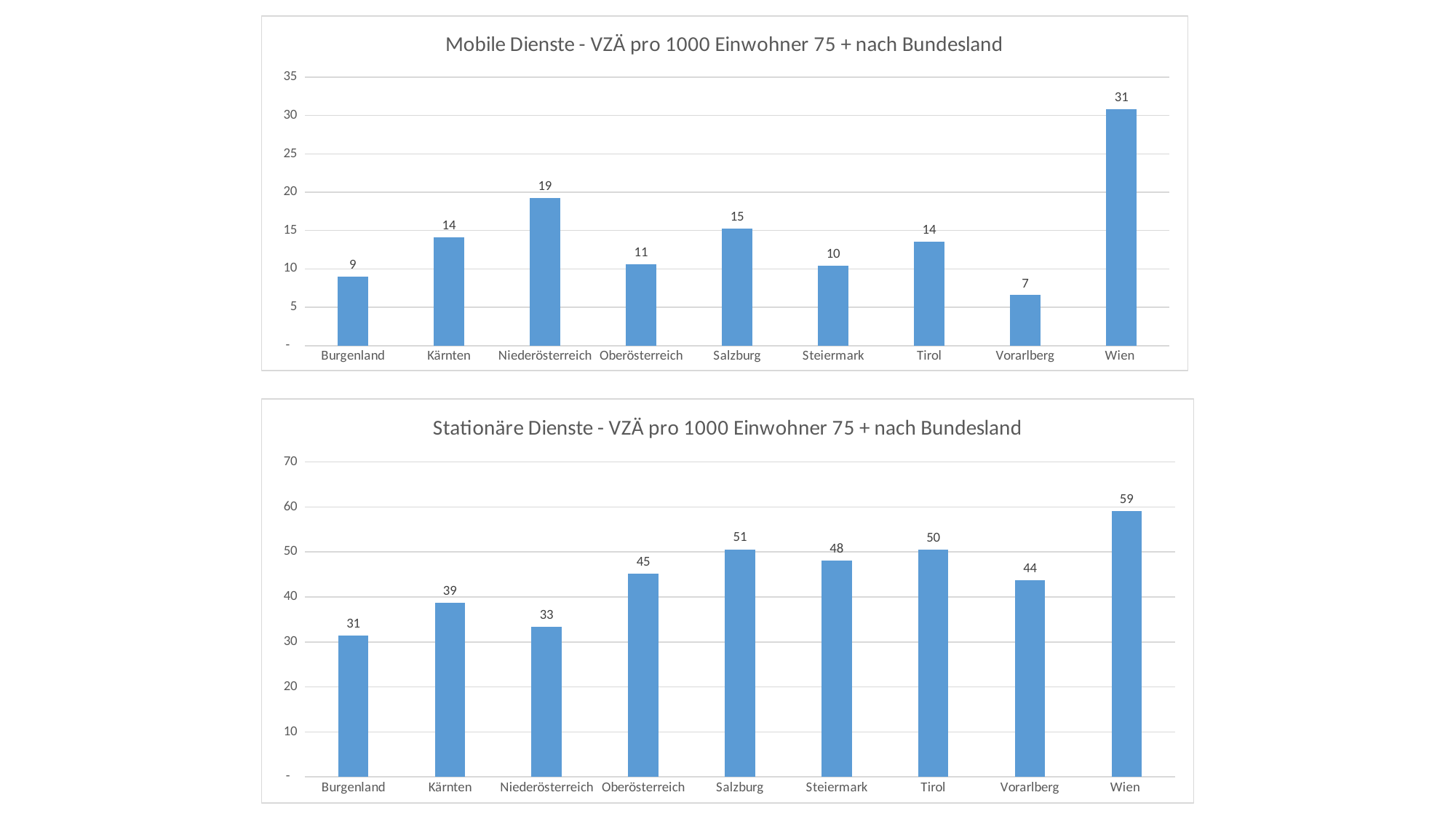
In the 'Mobile Dienste' chart, what is the difference between the values for Wien and Burgenland? 22 What kind of chart is the 'Stationäre Dienste' chart at the bottom of the slide? Bar chart In the 'Mobile Dienste' chart, how many Bundesländer are shown on the x axis? 9 In the 'Stationäre Dienste' chart, which Bundesland has the lowest value? Burgenland In the 'Stationäre Dienste' chart, which Bundesland has the highest value? Wien In the 'Mobile Dienste' chart, is the value for Salzburg greater or less than 10? greater In the 'Stationäre Dienste' chart, which is larger, the value for Kärnten or the value for Oberösterreich? Oberösterreich In the 'Stationäre Dienste - VZÄ pro 1000 Einwohner 75 + nach Bundesland' chart, what is the value for Steiermark? 48 In the 'Mobile Dienste' chart, which Bundesland has the lowest value? Vorarlberg In the 'Stationäre Dienste' chart, what is the difference between the values for Salzburg and Niederösterreich? 18 In the 'Mobile Dienste - VZÄ pro 1000 Einwohner 75 + nach Bundesland' chart, what is the value for Niederösterreich? 19 In the 'Mobile Dienste' chart, which Bundesland has the highest value? Wien